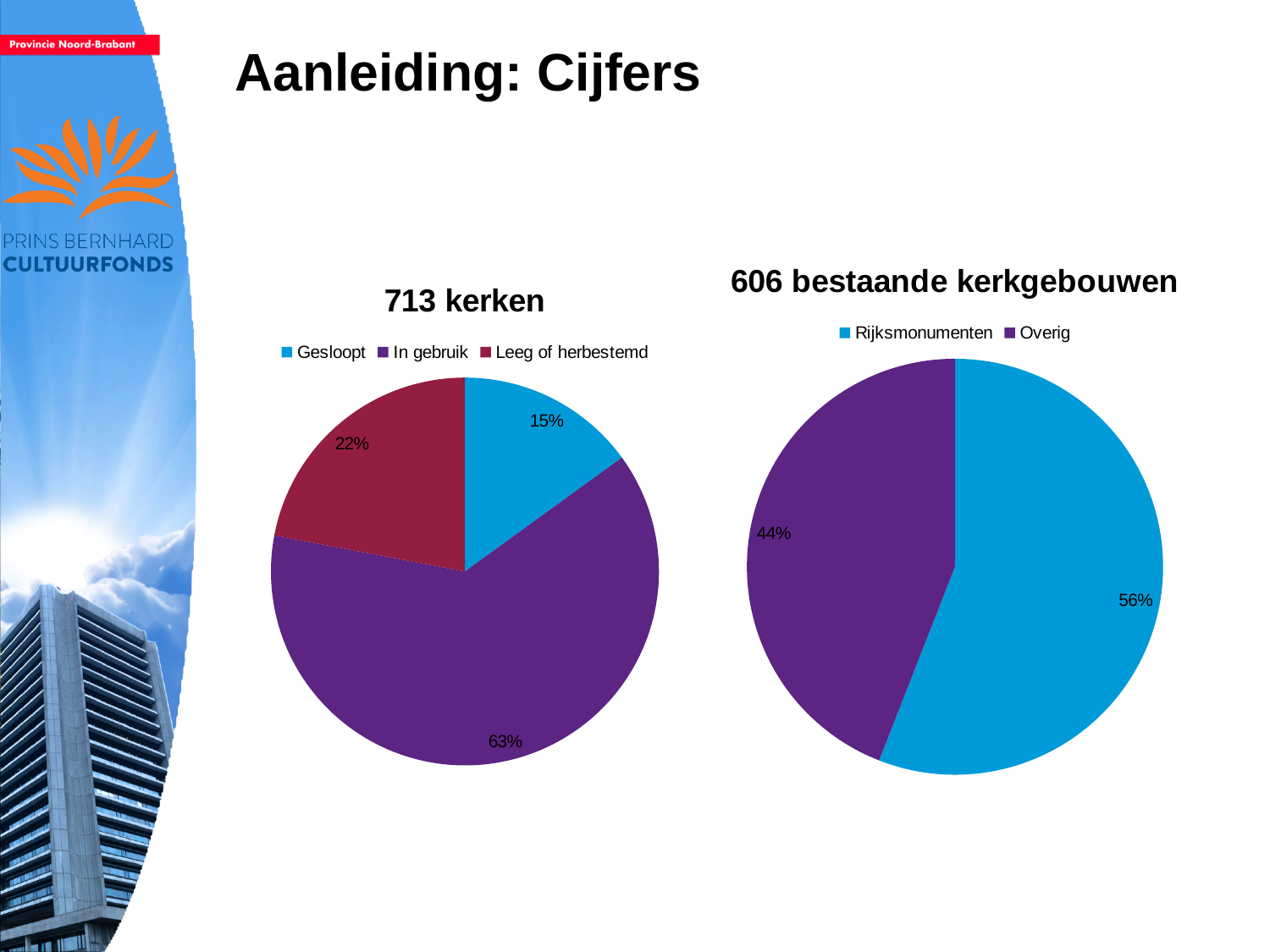
In the "713 kerken" chart, which category has the smallest slice? Gesloopt In the "606 bestaande kerkgebouwen" chart, what share of the pie is "Rijksmonumenten"? 56% What is the title of the chart on the left of the slide? 713 kerken In the "713 kerken" chart, what share of the pie is "In gebruik"? 63% In the "606 bestaande kerkgebouwen" chart, which is larger, "Rijksmonumenten" or "Overig"? Rijksmonumenten In the "713 kerken" chart, what share of the pie is "Leeg of herbestemd"? 22% In the "713 kerken" chart, which category has the largest slice? In gebruik In the "713 kerken" chart, what is the difference in percentage points between "In gebruik" and "Leeg of herbestemd"? 41 In the "713 kerken" chart, how many categories does the legend list? 3 What kind of chart is the "606 bestaande kerkgebouwen" chart? Pie chart